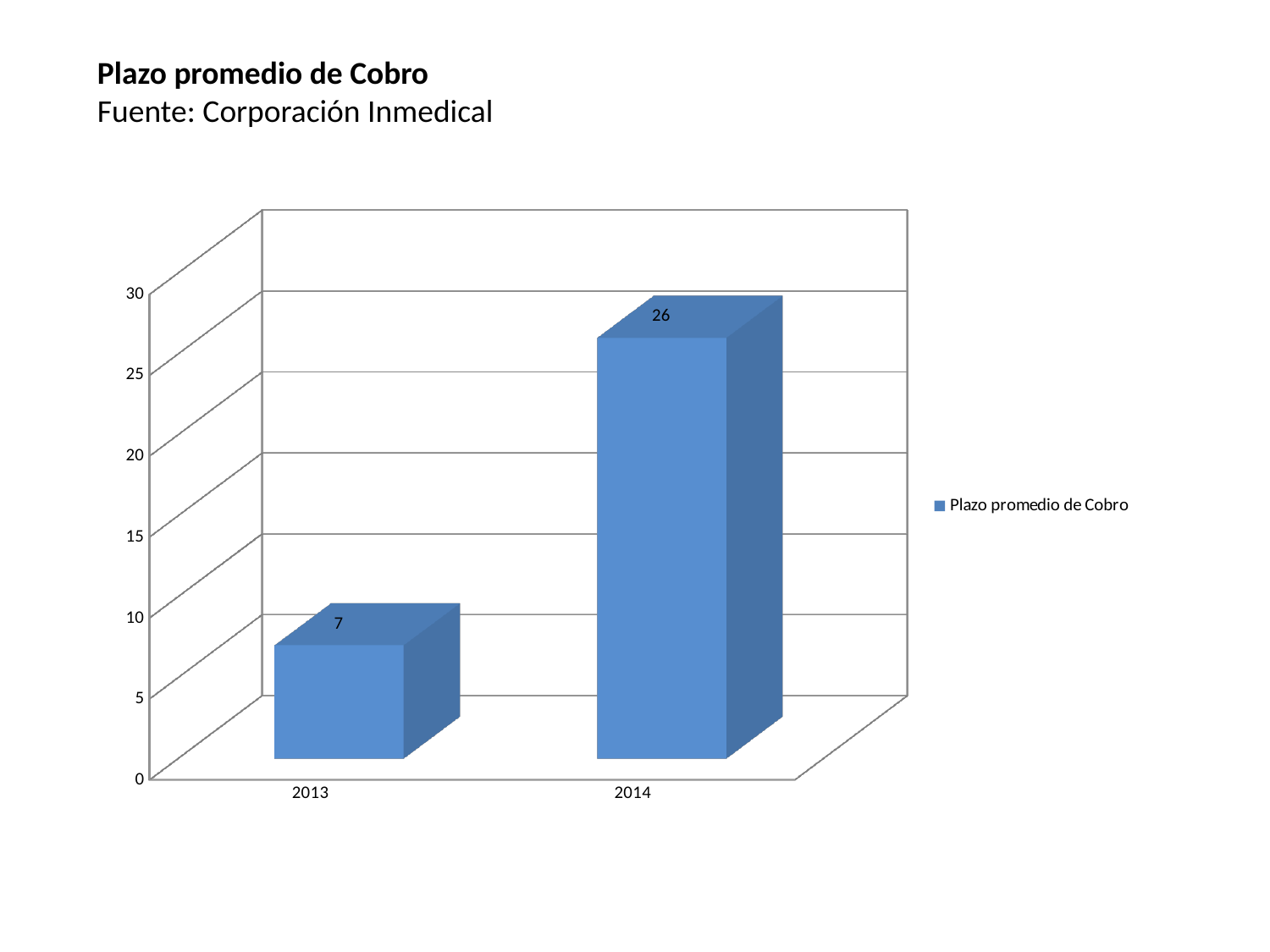
What is the difference between the values for 2014 and 2013? 19 Is the value for 2014 greater or less than 20? greater What is the value for 2014? 26 Do the values rise or fall from 2013 to 2014? rise Which year has the highest value? 2014 Is the value for 2013 greater or less than 10? less How many categories are shown on the x axis? 2 How many series does the legend list? 1 Which is larger, the value for 2013 or the value for 2014? 2014 What kind of chart is shown? bar chart What is the value for 2013? 7 Which year has the lowest value? 2013